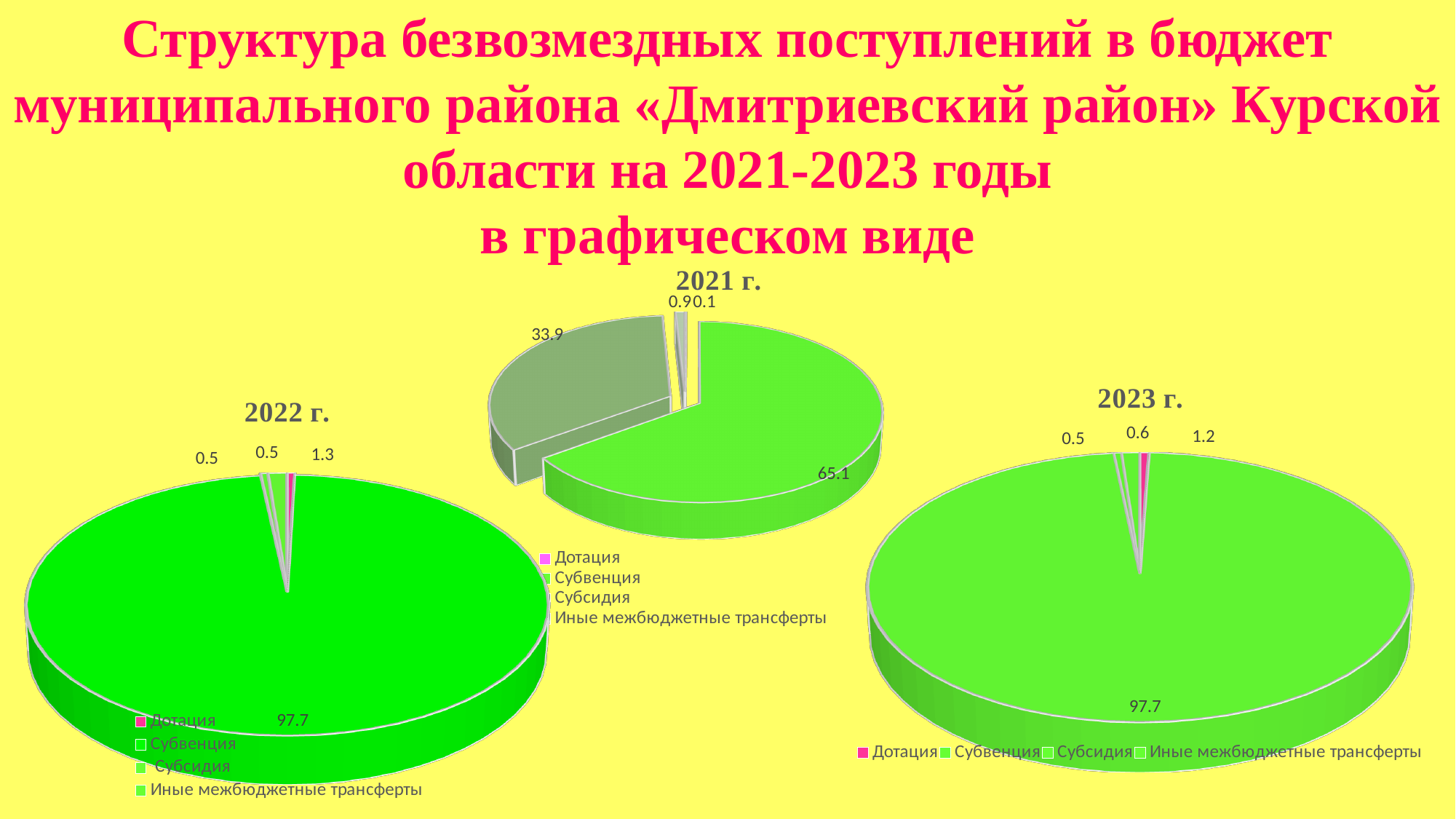
Is the largest slice in the 2021 г. chart larger or smaller than the largest slice in the 2022 г. chart? smaller In the 2021 г. chart, what is the value of the largest slice? 65.1 In the 2021 г. chart, what is the value of the Субвенция slice? 65.1 In the 2021 г. chart, what is the difference between the two largest slices, 65.1 and 33.9? 31.2 How many entries does the legend of the 2023 г. chart list? 4 In the 2023 г. chart, what is the difference between the slices labelled 1.2 and 0.6? 0.6 What is the first entry in the legend of the 2022 г. chart? Дотация In the 2022 г. chart, what is the value of the largest slice? 97.7 What kind of chart is the 2021 г. chart? pie chart How many slices does the 2021 г. pie chart have? 4 In the 2023 г. chart, what is the value of the largest slice? 97.7 In the 2021 г. chart, what is the value of the smallest slice? 0.1